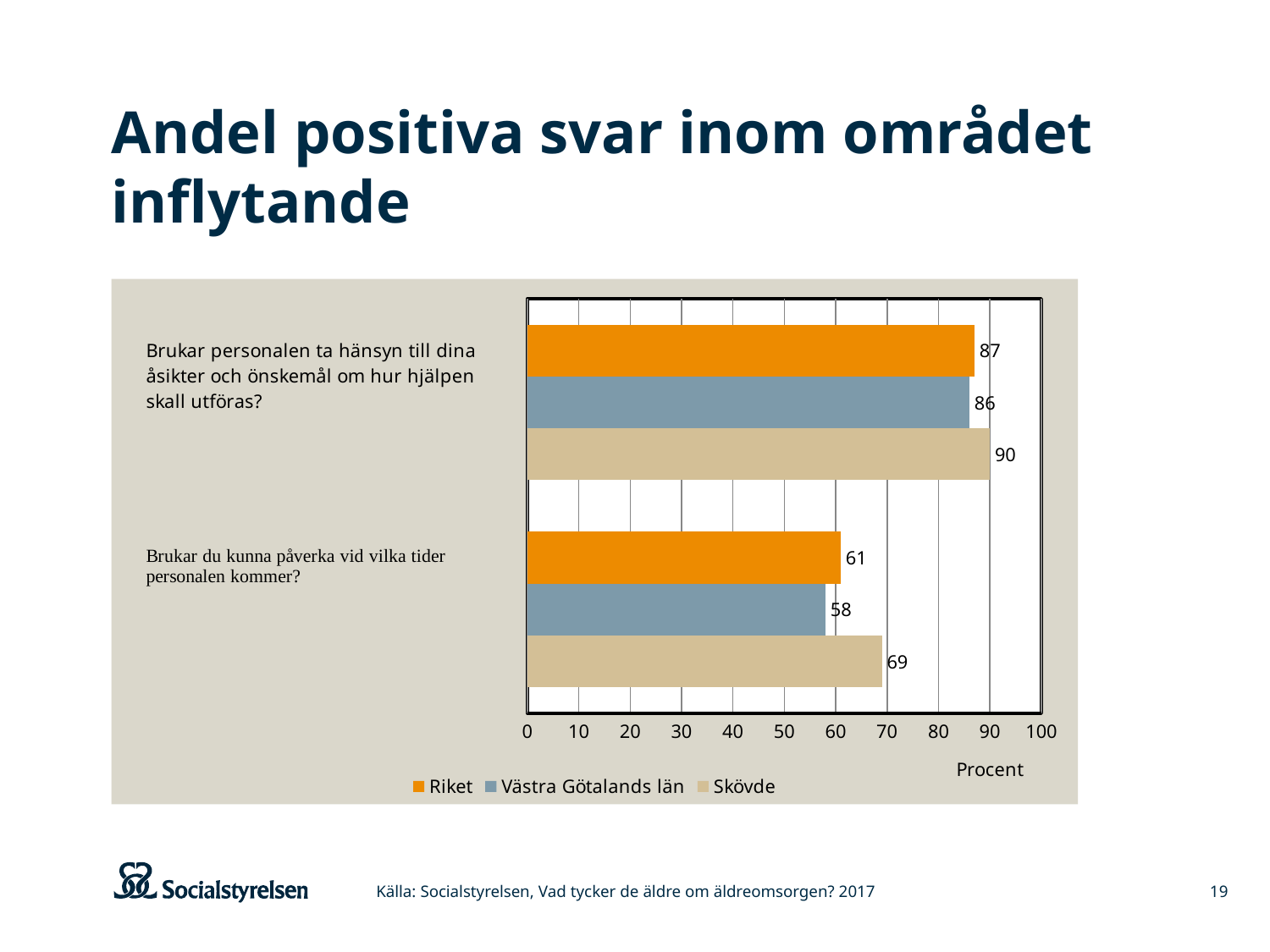
How many questions (categories) are shown on the chart? 2 What kind of chart is shown on the slide? Bar chart Which series has the highest value for the question "Brukar du kunna påverka vid vilka tider personalen kommer?"? Skövde Which series has the lowest value for the question "Brukar du kunna påverka vid vilka tider personalen kommer?"? Västra Götalands län What is the difference between Skövde and Västra Götalands län on the question "Brukar personalen ta hänsyn till dina åsikter och önskemål om hur hjälpen skall utföras?"? 4 What value is shown for Riket on the question "Brukar du kunna påverka vid vilka tider personalen kommer?"? 61 What is the difference between Skövde and Riket on the question "Brukar du kunna påverka vid vilka tider personalen kommer?"? 8 What value is shown for Västra Götalands län on the question "Brukar du kunna påverka vid vilka tider personalen kommer?"? 58 How many series does the legend list? 3 What value is shown for Skövde on the question "Brukar personalen ta hänsyn till dina åsikter och önskemål om hur hjälpen skall utföras?"? 90 What unit is labelled on the horizontal axis of the chart? Procent Which is larger for Riket: the value for "Brukar personalen ta hänsyn till dina åsikter..." or for "Brukar du kunna påverka vid vilka tider personalen kommer?"? Brukar personalen ta hänsyn till dina åsikter och önskemål om hur hjälpen skall utföras?